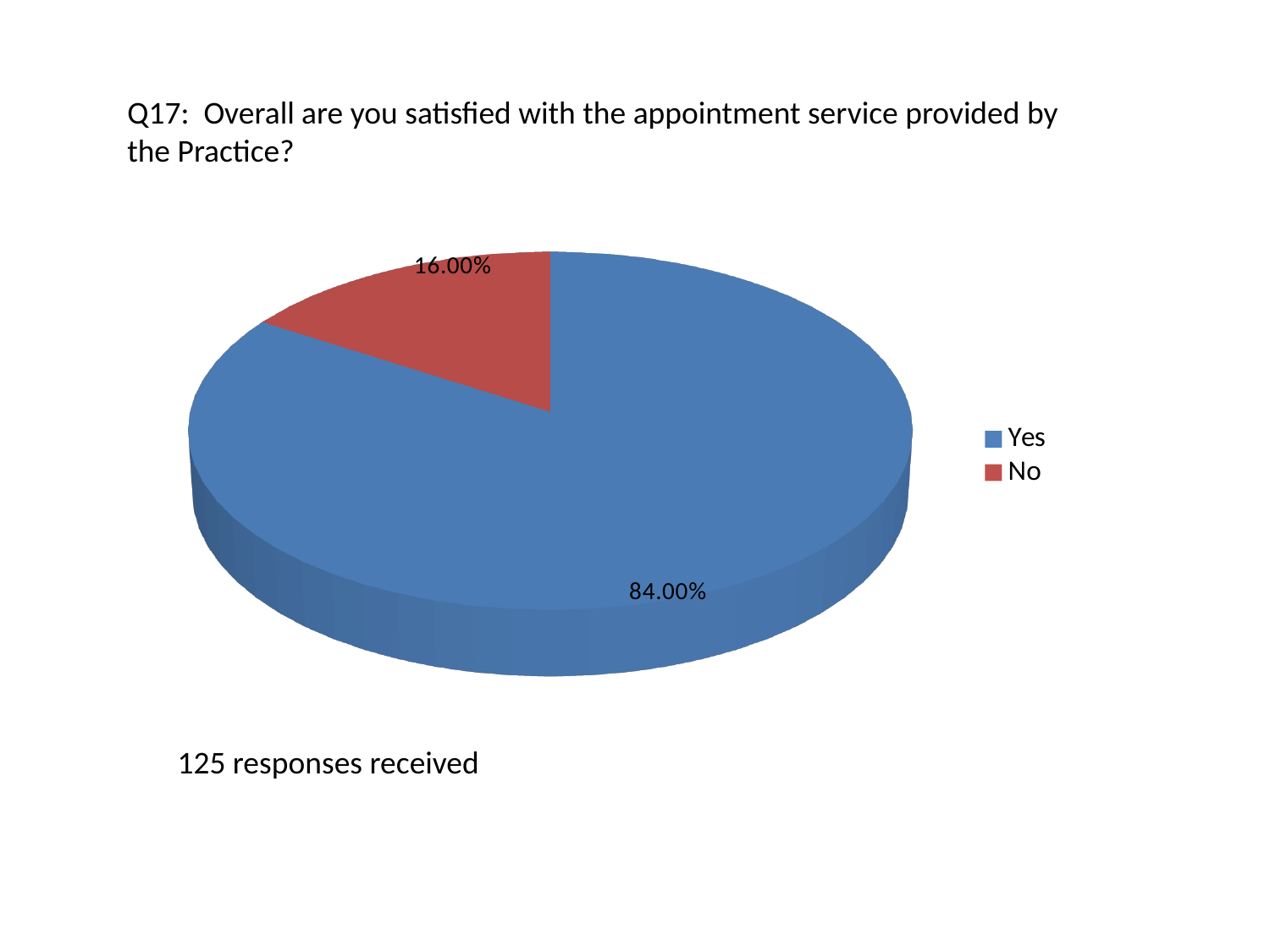
What colour is the Yes slice? blue Which is larger, the share for Yes or the share for No? Yes Which response has the largest share of the pie? Yes What kind of chart is shown on the slide? pie chart Which response has the smallest share of the pie? No What is the difference in percentage points between the Yes and No shares? 68.00% How many entries does the legend list? 2 How many responses were received according to the slide? 125 What percentage of respondents answered No? 16.00% How many slices does the pie chart have? 2 What percentage of respondents answered Yes? 84.00%